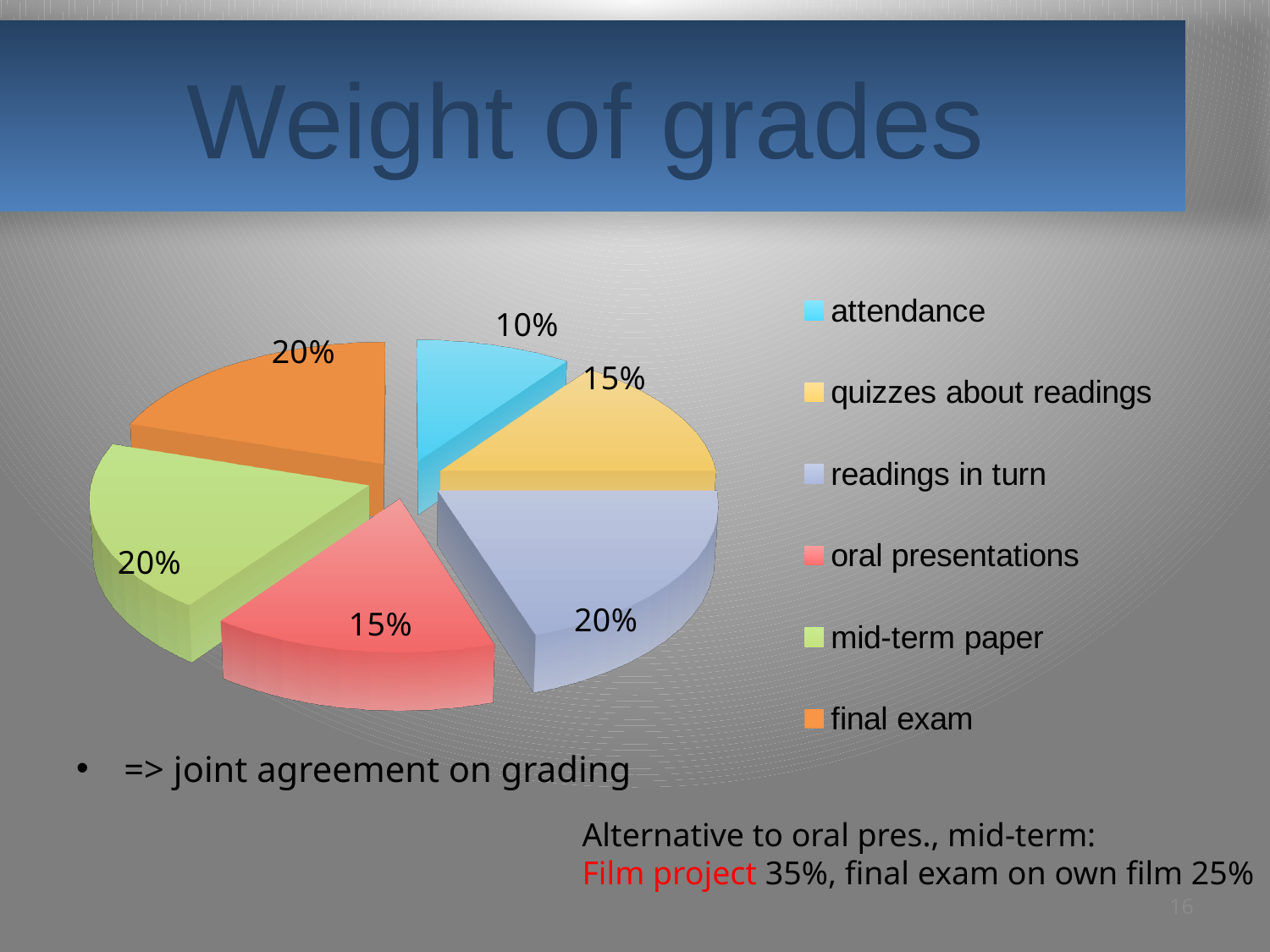
What percentage is shown for attendance? 10% How many categories does the legend list? 6 Which category has the smallest slice of the pie? attendance What colour is the slice for the final exam? orange Which is larger, the slice for attendance or the slice for quizzes about readings? quizzes about readings What is the difference between the final exam percentage and the attendance percentage? 10% What is the title of the chart? Weight of grades What type of chart is shown on the slide? pie chart What percentage is shown for the final exam? 20% What percentage is shown for oral presentations? 15% What percentage is shown for quizzes about readings? 15% What percentage is shown for readings in turn? 20%